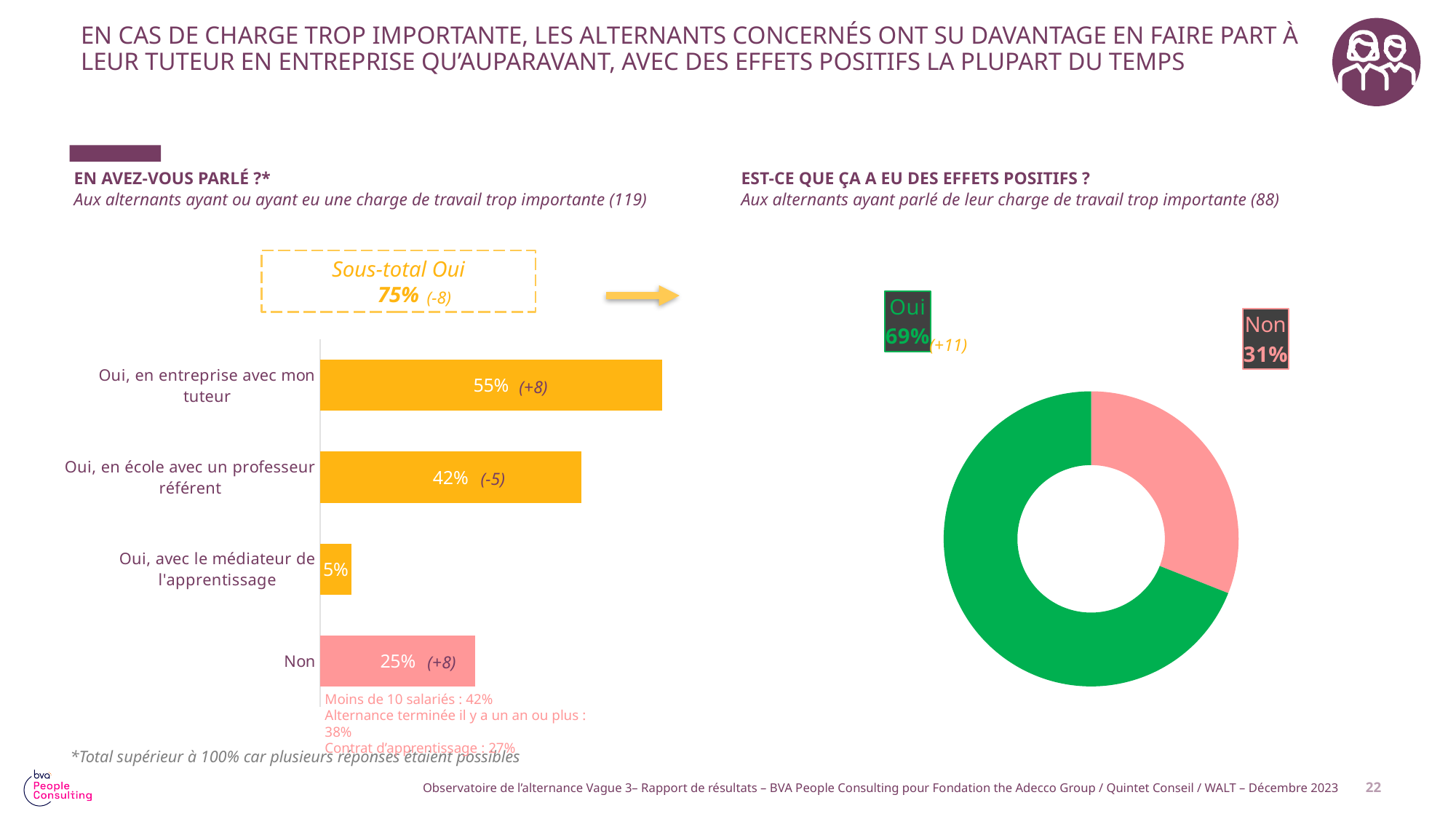
In the donut chart 'EST-CE QUE ÇA A EU DES EFFETS POSITIFS ?', what is the share for 'Non'? 31% In the bar chart 'EN AVEZ-VOUS PARLÉ ?', what is the value for 'Oui, avec le médiateur de l'apprentissage'? 5% In the donut chart 'EST-CE QUE ÇA A EU DES EFFETS POSITIFS ?', which is larger, 'Oui' or 'Non'? Oui In the bar chart 'EN AVEZ-VOUS PARLÉ ?', which category has the highest value? Oui, en entreprise avec mon tuteur What type of chart is used for 'EN AVEZ-VOUS PARLÉ ?'? Bar chart In the donut chart 'EST-CE QUE ÇA A EU DES EFFETS POSITIFS ?', what is the share for 'Oui'? 69% In the bar chart 'EN AVEZ-VOUS PARLÉ ?', what is the value for 'Non'? 25% In the bar chart 'EN AVEZ-VOUS PARLÉ ?', what is the value for 'Oui, en école avec un professeur référent'? 42% In the bar chart 'EN AVEZ-VOUS PARLÉ ?', what is the value for 'Oui, en entreprise avec mon tuteur'? 55% In the bar chart 'EN AVEZ-VOUS PARLÉ ?', how many categories are shown? 4 In the bar chart 'EN AVEZ-VOUS PARLÉ ?', what is the difference between 'Oui, en entreprise avec mon tuteur' and 'Oui, en école avec un professeur référent'? 13% In the bar chart 'EN AVEZ-VOUS PARLÉ ?', which category has the lowest value? Oui, avec le médiateur de l'apprentissage